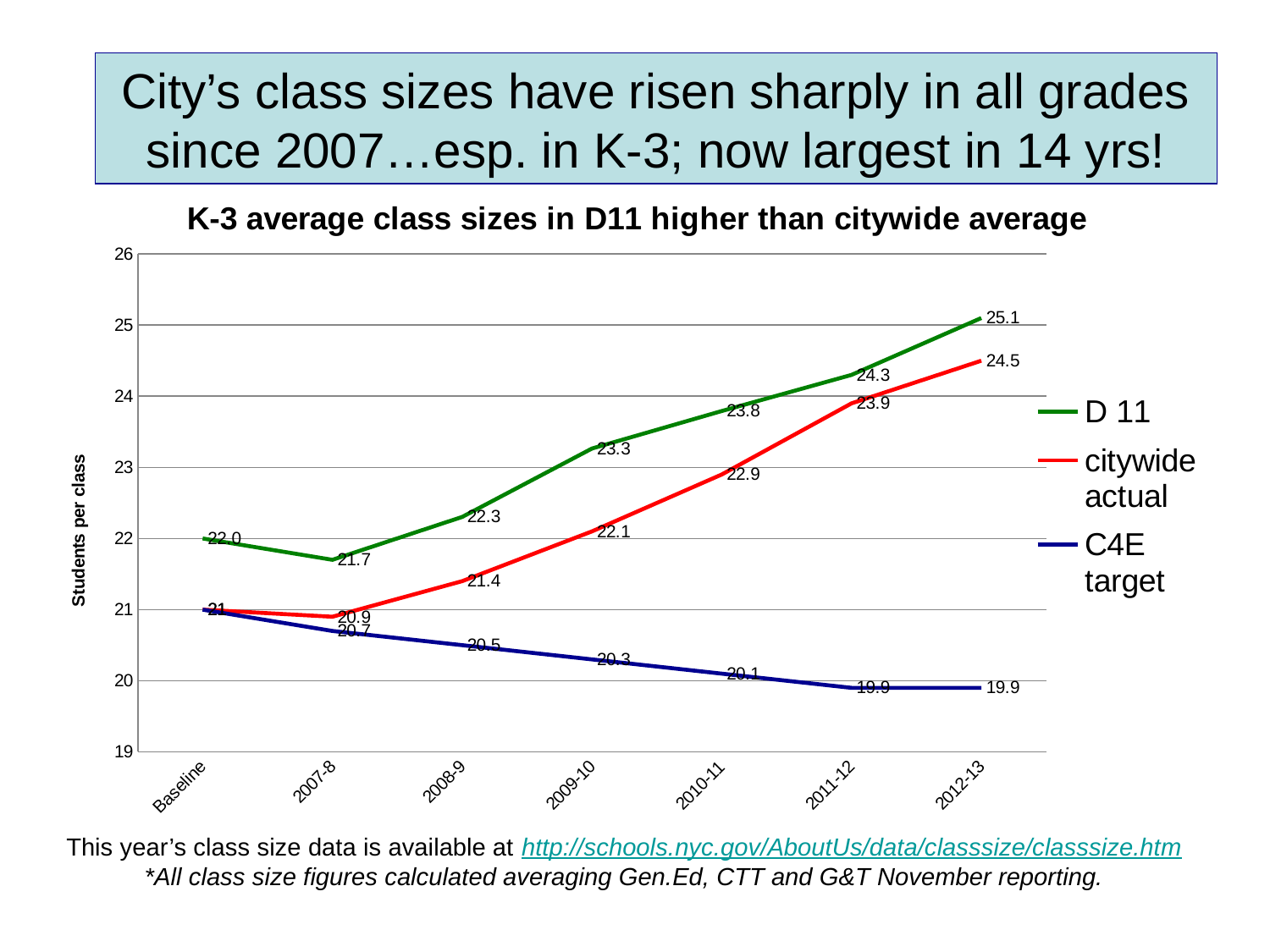
What is the D 11 value for 2012-13? 25.1 What kind of chart is shown on the slide? line chart How many series does the legend list? 3 Does the C4E target series rise or fall from Baseline to 2012-13? fall Is the citywide actual value for 2008-9 greater or less than 22? less How many points are plotted along the x axis for each series? 7 In which year is the D 11 value lowest? 2007-8 What is the C4E target value for 2011-12? 19.9 What is the citywide actual value for 2010-11? 22.9 In 2009-10, which is larger: the D 11 value or the citywide actual value? D 11 What is the difference between the D 11 and citywide actual values in 2012-13? 0.6 In which year is the D 11 value highest? 2012-13